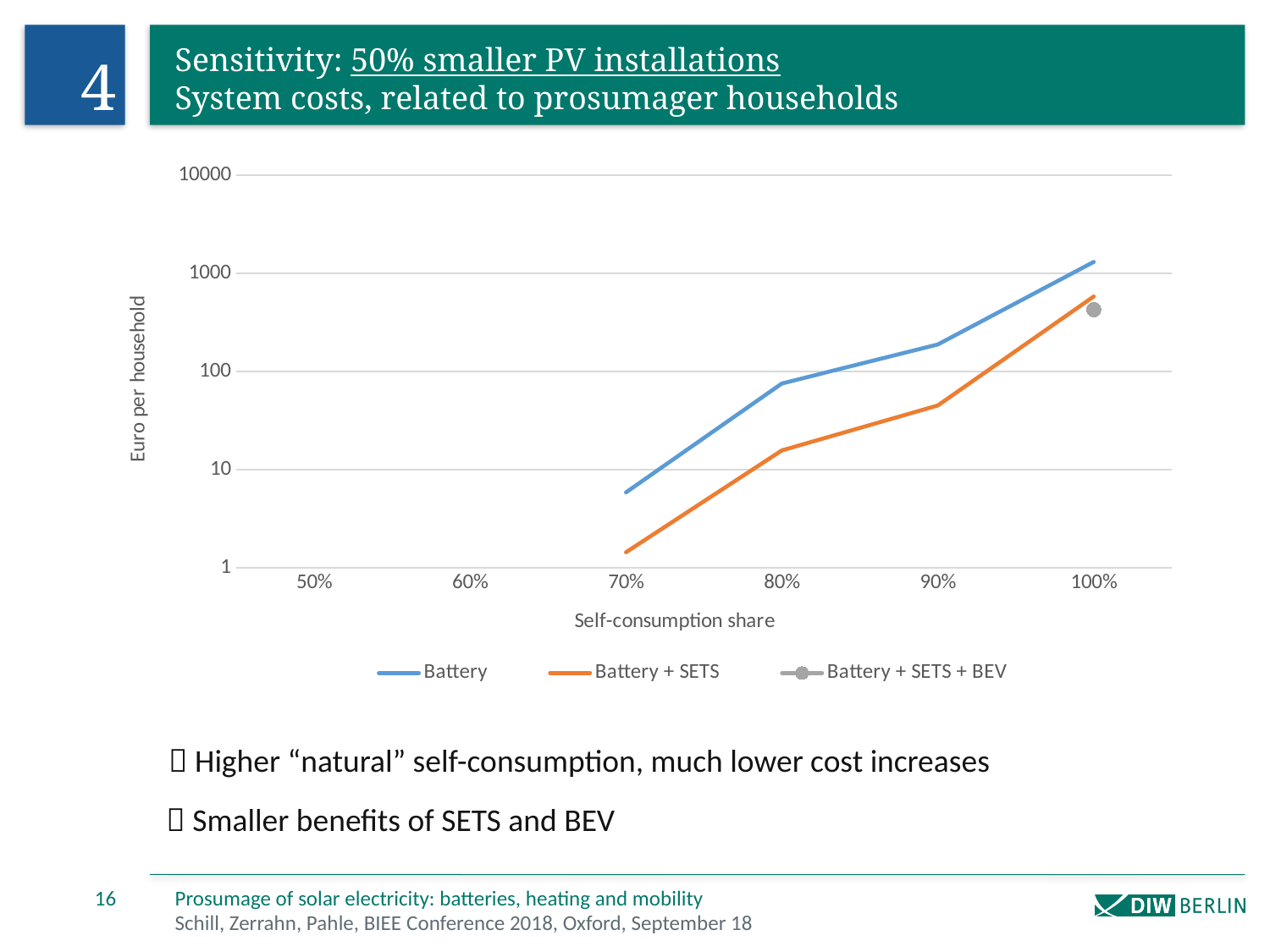
Which series has the highest value at 100% self-consumption share? Battery At 100% self-consumption share, which is larger: Battery or Battery + SETS? Battery What kind of chart is shown on the slide? Line chart How many self-consumption share values are marked on the x axis? 6 What is the label of the y axis? Euro per household What is the label of the x axis? Self-consumption share Is the value for Battery at 80% self-consumption share greater or less than 100? less How many series does the legend list? 3 Is the value for Battery + SETS at 70% self-consumption share greater or less than 10? less Is the value for Battery at 100% self-consumption share greater or less than 1000? greater Does the Battery series rise or fall as the self-consumption share increases from 70% to 100%? Rise